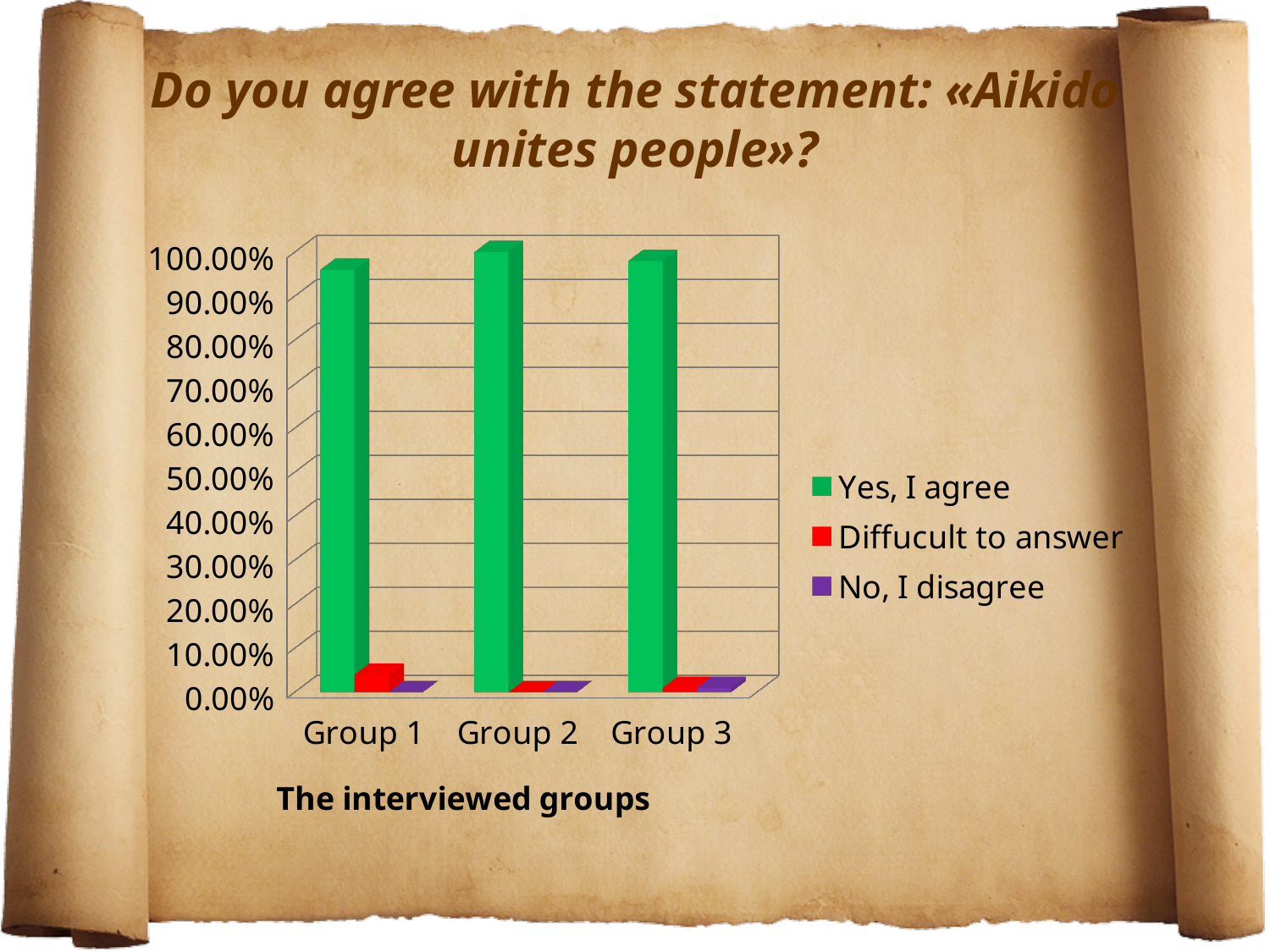
What is the title of the chart's x axis? The interviewed groups How many groups are shown on the x axis of the chart? 3 How many series does the chart's legend list? 3 What kind of chart is shown on the slide? Bar chart Which colour represents "No, I disagree" in the chart? Purple Which series has the highest value in every group? Yes, I agree Is the value for "Difficult to answer" in Group 1 greater or less than 10.00%? less Is the value for "No, I disagree" in Group 2 greater or less than 10.00%? less Is the value for "Yes, I agree" in Group 1 greater or less than 90.00%? greater Which is larger: the "Yes, I agree" value for Group 1 or for Group 2? Group 2 Which group has the highest value for "Difficult to answer"? Group 1